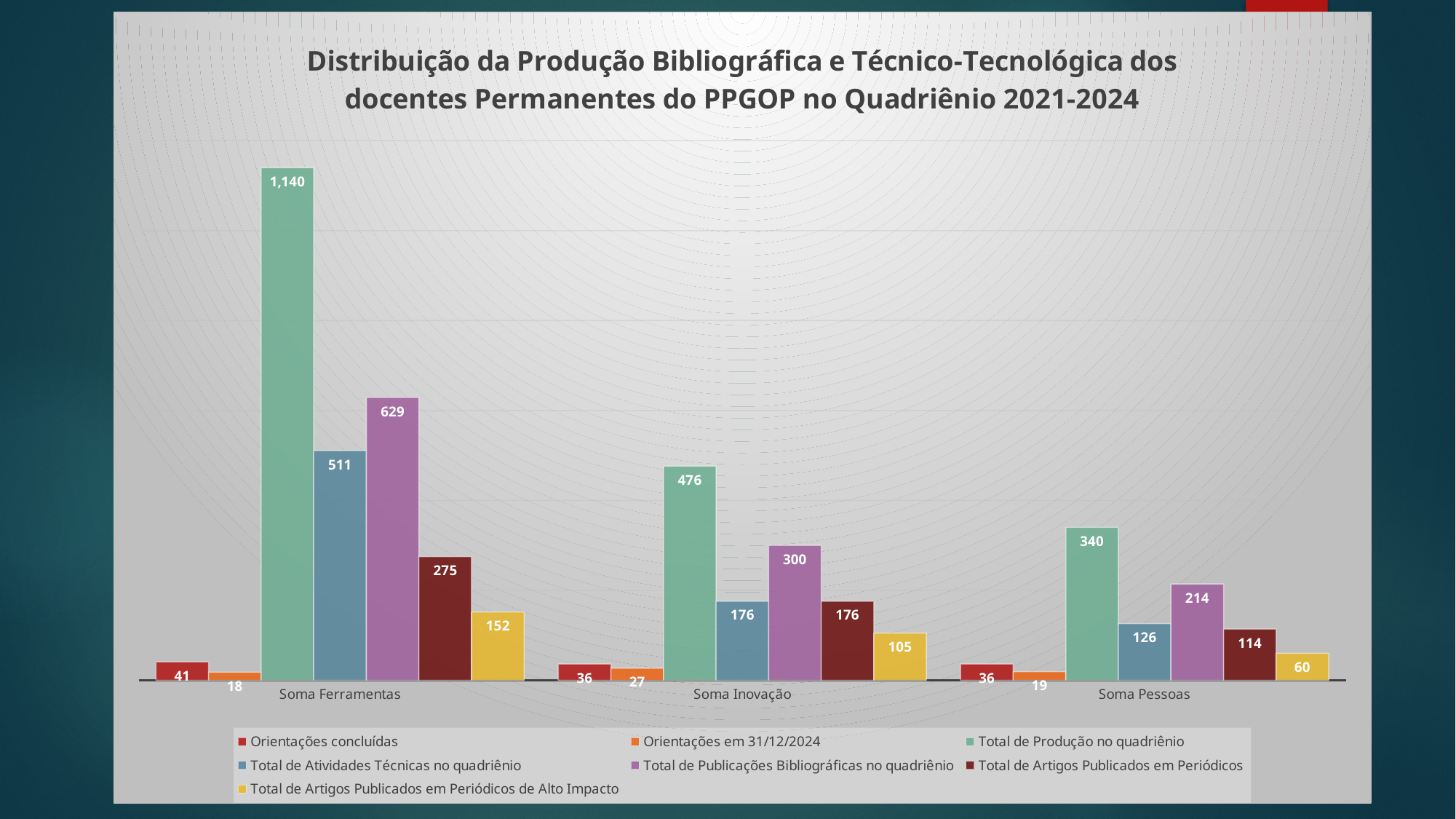
How many categories are shown on the x axis? 3 Which category has the highest value for Total de Atividades Técnicas no quadriênio? Soma Ferramentas What is the value of Total de Artigos Publicados em Periódicos de Alto Impacto for Soma Pessoas? 60 Which is larger: Total de Artigos Publicados em Periódicos for Soma Inovação or Total de Atividades Técnicas no quadriênio for Soma Pessoas? Total de Artigos Publicados em Periódicos for Soma Inovação What is the value of Total de Produção no quadriênio for Soma Ferramentas? 1,140 How many series does the legend list? 7 What is the value of Orientações em 31/12/2024 for Soma Ferramentas? 18 Does the value of Total de Publicações Bibliográficas no quadriênio rise or fall from Soma Ferramentas to Soma Pessoas? Fall What is the difference between Total de Produção no quadriênio for Soma Ferramentas and for Soma Inovação? 664 What kind of chart is shown on the slide? Bar chart What is the value of Total de Publicações Bibliográficas no quadriênio for Soma Inovação? 300 Which category has the lowest value for Total de Produção no quadriênio? Soma Pessoas